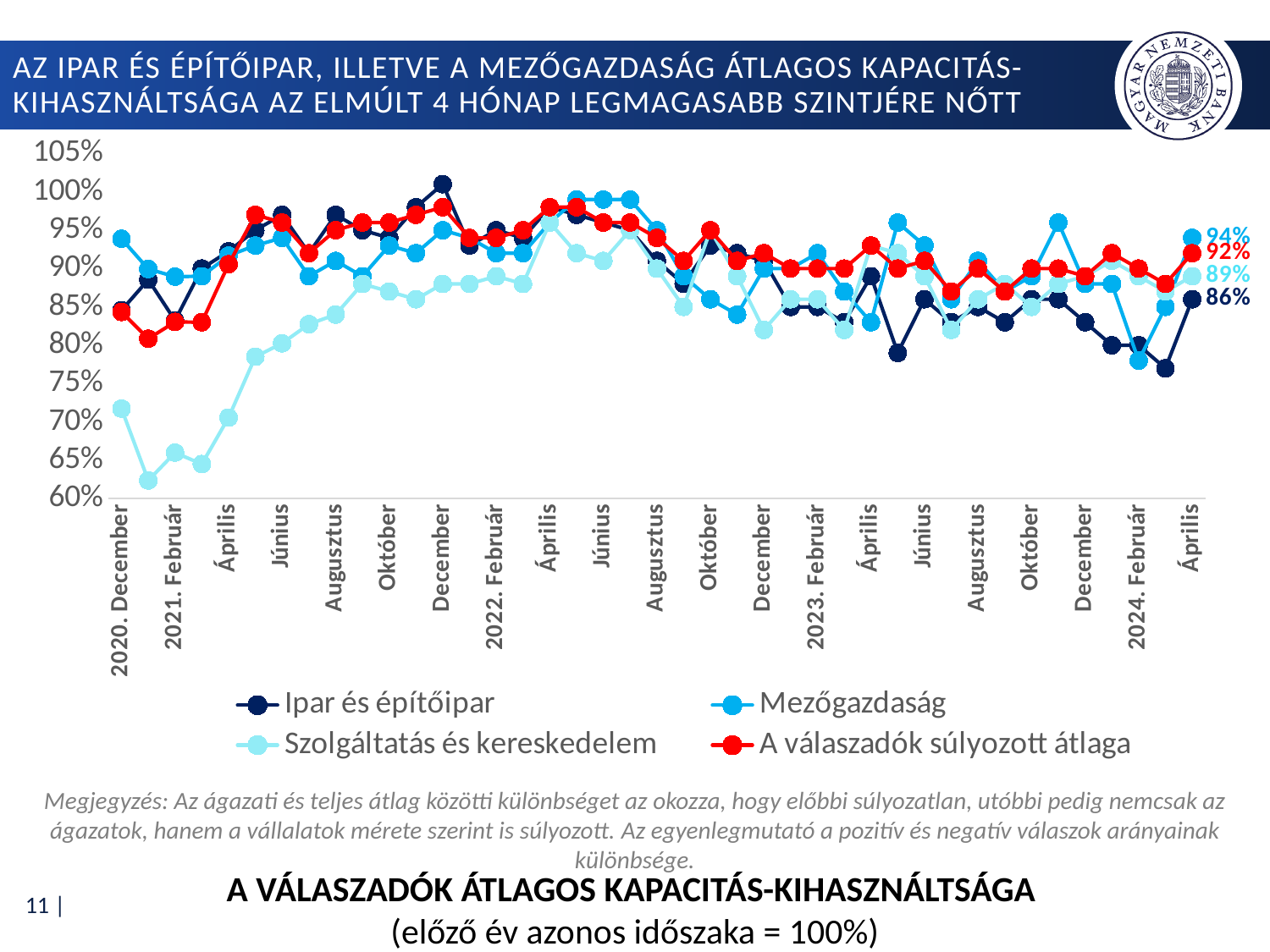
At the last point (2024 Április), which is larger: A válaszadók súlyozott átlaga or Szolgáltatás és kereskedelem? A válaszadók súlyozott átlaga What kind of chart is shown on the slide? Line chart Which series has the highest value at the last point (2024 Április)? Mezőgazdaság What is the value for A válaszadók súlyozott átlaga at the last point (2024 Április)? 92% What is the value for Szolgáltatás és kereskedelem at the last point (2024 Április)? 89% How many series does the legend list? 4 Is the value for Szolgáltatás és kereskedelem in 2020 December greater or less than 75%? less What is the difference between the Mezőgazdaság and Ipar és építőipar values at the last point (2024 Április)? 8 percentage points What is the value for Ipar és építőipar at the last point (2024 Április)? 86% What is the value for Mezőgazdaság at the last point (2024 Április)? 94% Which series has the lowest value at the last point (2024 Április)? Ipar és építőipar Does the Szolgáltatás és kereskedelem series rise or fall between 2021 Február and 2021 Június? Rise